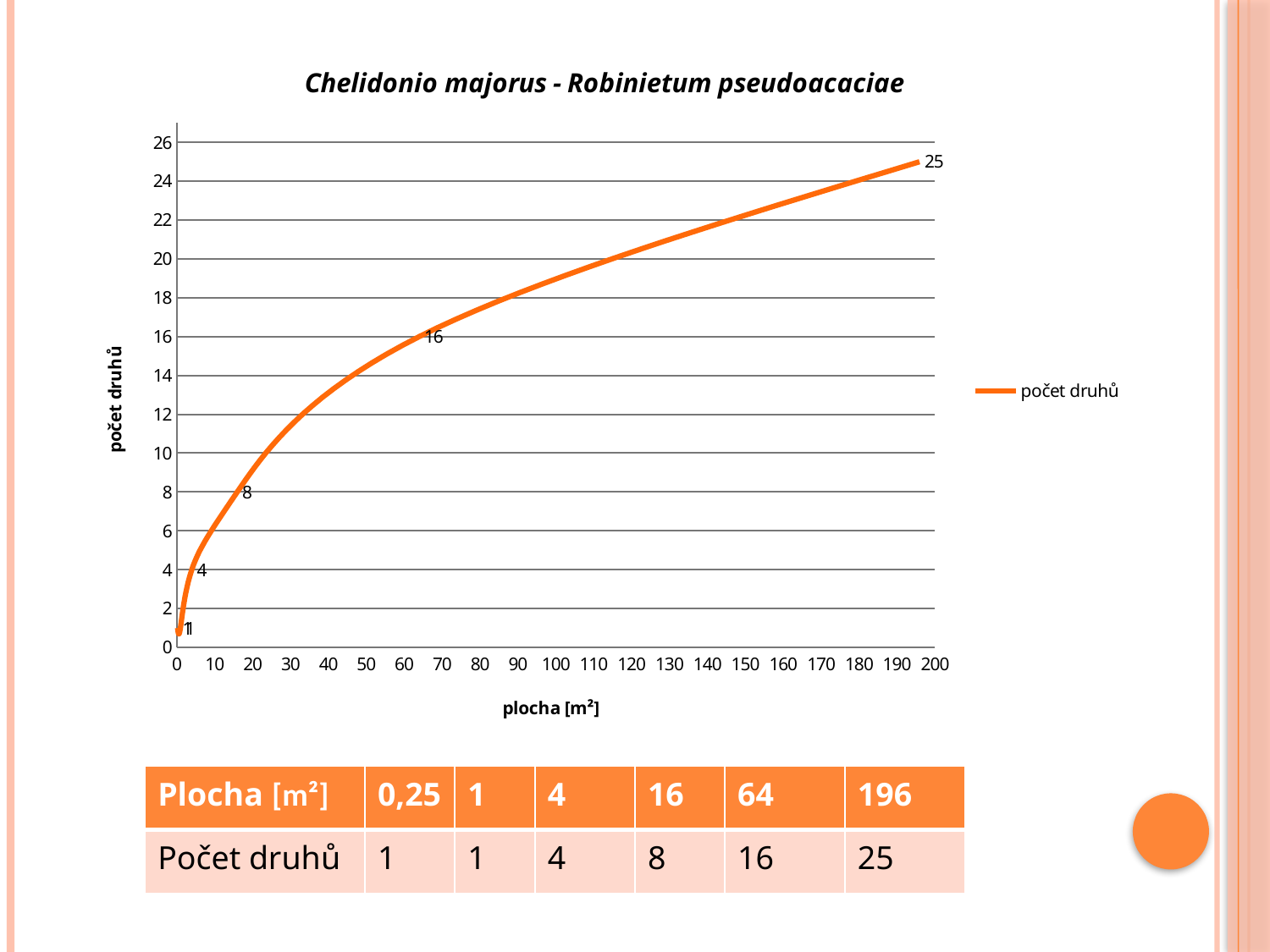
What is the name of the series shown in the legend? počet druhů What is the title of the chart? Chelidonio majorus - Robinietum pseudoacaciae How many series does the chart legend list? 1 How many data points are plotted on the line? 6 What is the number of species (počet druhů) at an area of 64 m²? 16 What is the difference in number of species between an area of 196 m² and an area of 64 m²? 9 What kind of chart is shown on the slide? line chart What is the number of species (počet druhů) at an area of 16 m²? 8 What is the number of species (počet druhů) at an area of 196 m²? 25 Does the number of species rise or fall as the area (plocha) increases along the x axis? rise What is the number of species (počet druhů) at an area of 4 m²? 4 What is the highest number of species shown on the chart? 25